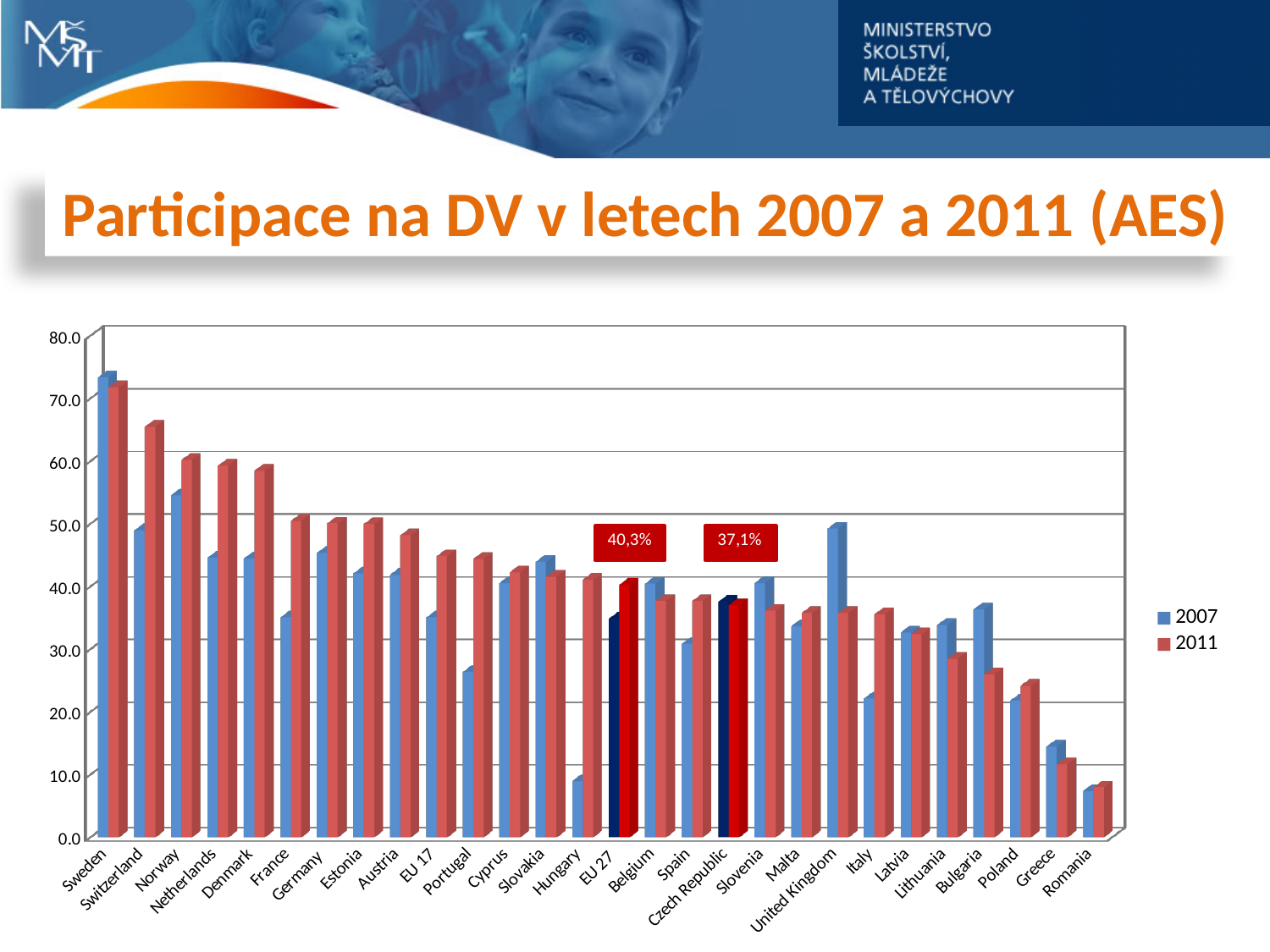
Which country has the lowest 2011 value? Romania For Hungary, which is larger: the 2007 value or the 2011 value? 2011 Is the 2011 value for Switzerland greater or less than 60.0? greater What is the labelled 2011 value for EU 27? 40,3% Which country has the highest 2007 value? Sweden What is the difference between the labelled 2011 values for EU 27 and the Czech Republic? 3,2% What kind of chart is shown on the slide? bar chart How many countries or groups are shown on the x axis? 28 How many series does the legend list? 2 Is the 2007 value for Portugal greater or less than 30.0? less What is the labelled 2011 value for the Czech Republic? 37,1% Do the 2011 values generally rise or fall from left to right along the x axis? fall